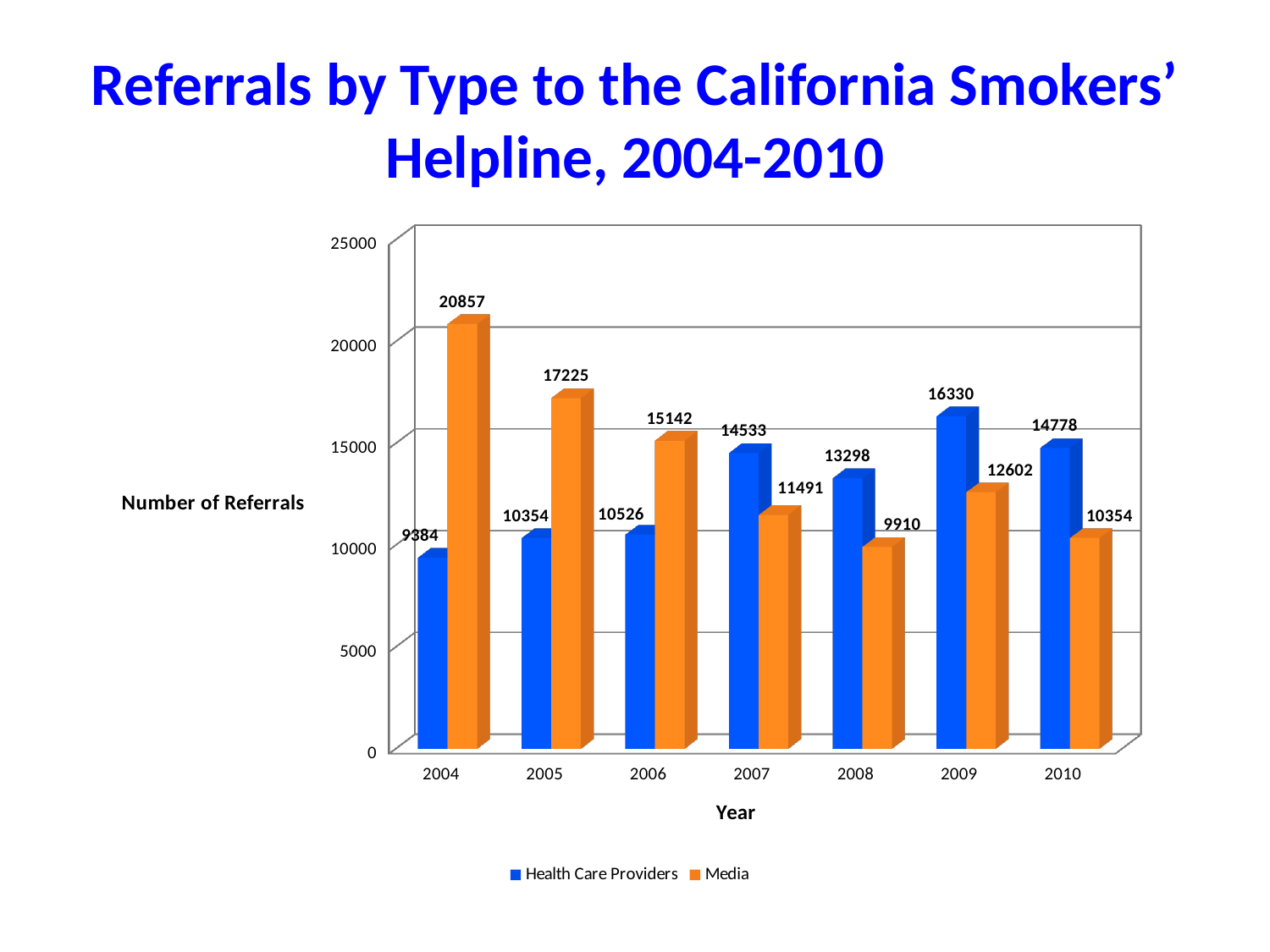
What kind of chart is shown on the slide? Bar chart In which year were Health Care Providers referrals highest? 2009 What is the number of Health Care Providers referrals in 2009? 16330 How many series does the legend list? 2 What is the number of Health Care Providers referrals in 2008? 13298 In which year were Media referrals lowest? 2008 What is the title of the vertical axis? Number of Referrals In 2007, which referral type had more referrals, Health Care Providers or Media? Health Care Providers What is the number of Media referrals in 2004? 20857 In 2004, how many more Media referrals were there than Health Care Providers referrals? 11473 Did Media referrals rise or fall from 2004 to 2008? Fall How many years are shown on the x axis? 7